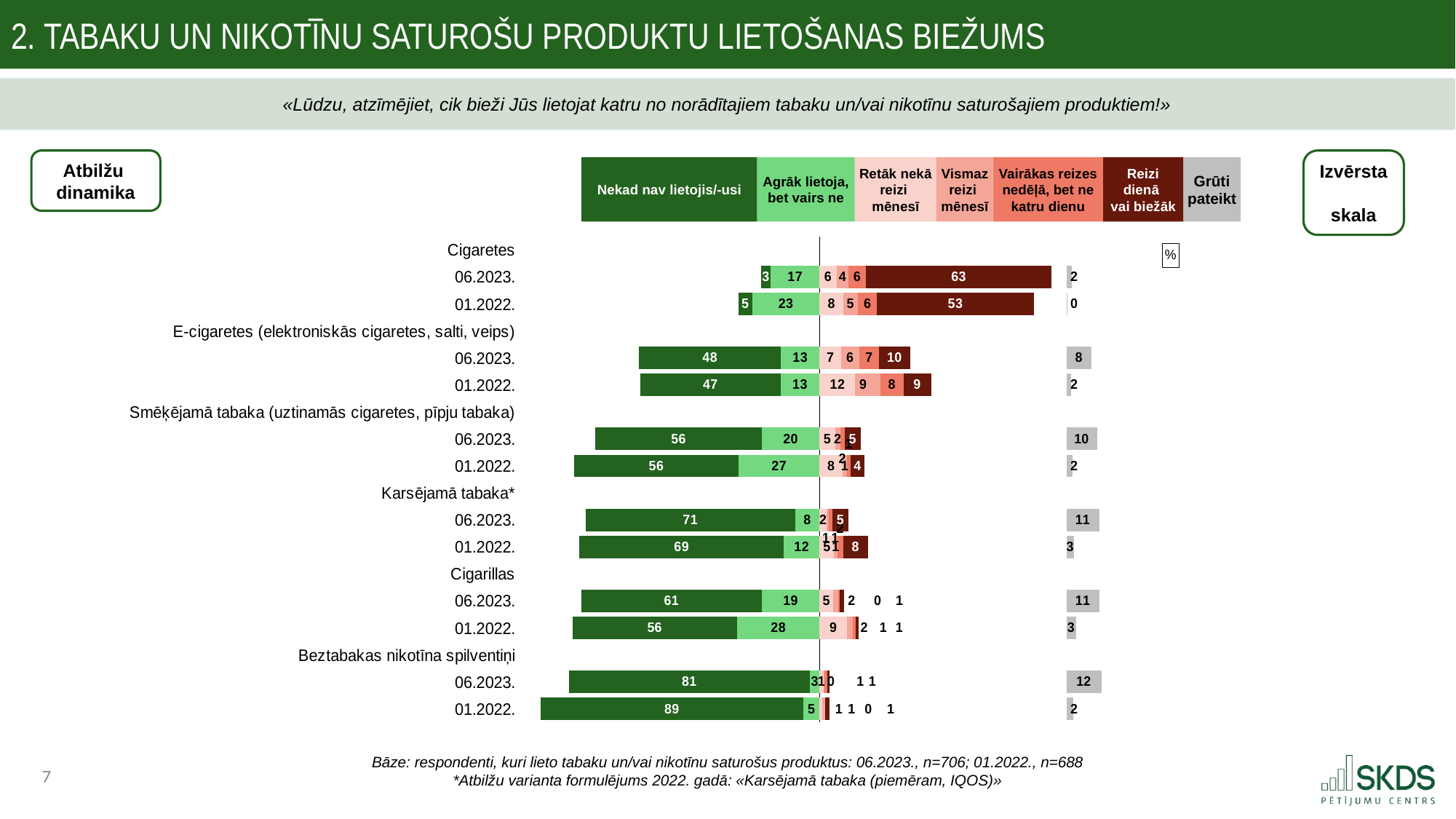
How many response categories (series) does the legend list? 7 What percentage of respondents in 06.2023 said they use cigarettes (Cigaretes) 'Reizi dienā vai biežāk'? 63 How many bars (product-wave combinations) are plotted in the chart? 12 What type of chart is shown on the slide? Stacked bar chart Which is larger: the 'Nekad nav lietojis/-usi' value for Cigarillas in 06.2023 or in 01.2022? 06.2023 Which product and wave has the highest 'Nekad nav lietojis/-usi' value? Beztabakas nikotīna spilventiņi, 01.2022 What is the difference between the 'Agrāk lietoja, bet vairs ne' values for Smēķējamā tabaka in 01.2022 (27) and 06.2023 (20)? 7 What is the 'Grūti pateikt' value for Beztabakas nikotīna spilventiņi in 06.2023? 12 What is the 'Nekad nav lietojis/-usi' value for Beztabakas nikotīna spilventiņi in 01.2022? 89 By how many percentage points did the 'Reizi dienā vai biežāk' value for Cigaretes change from 01.2022 (53) to 06.2023 (63)? 10 What is the 'Agrāk lietoja, bet vairs ne' value for Cigarillas in 01.2022? 28 Which legend category is shown in the dark red/brown colour? Reizi dienā vai biežāk